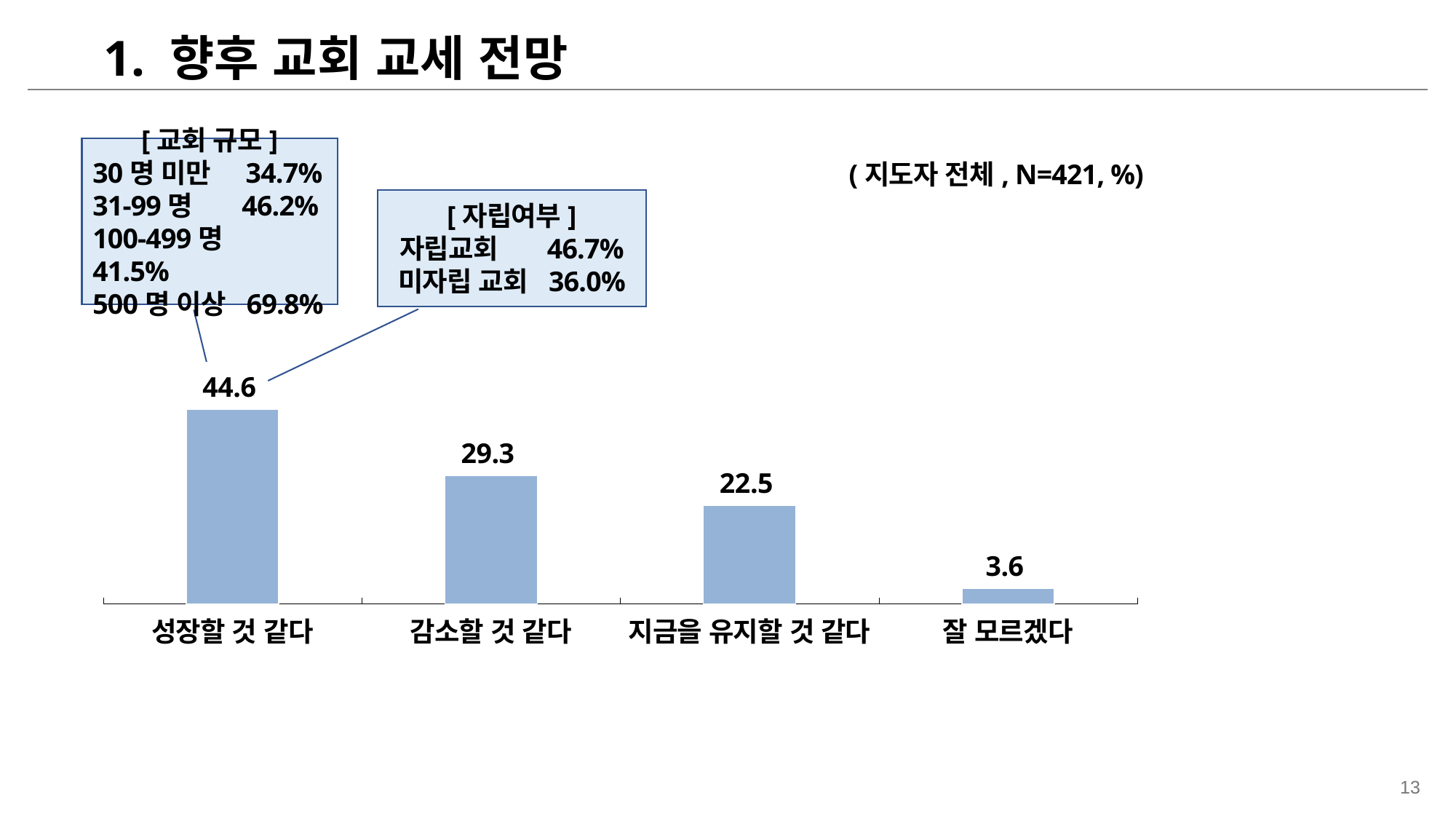
Which category has the lowest value? 잘 모르겠다 Which category has the highest value? 성장할 것 같다 What is the value for 지금을 유지할 것 같다? 22.5 Do the values rise or fall from left to right along the x axis? fall What is the value for 성장할 것 같다? 44.6 What is the value for 잘 모르겠다? 3.6 How many categories are shown in the chart? 4 What is the value for 감소할 것 같다? 29.3 Which is larger, the value for 감소할 것 같다 or the value for 지금을 유지할 것 같다? 감소할 것 같다 What is the difference between the values for 성장할 것 같다 and 감소할 것 같다? 15.3 What kind of chart is shown on the slide? bar chart What is the difference between the values for 지금을 유지할 것 같다 and 잘 모르겠다? 18.9